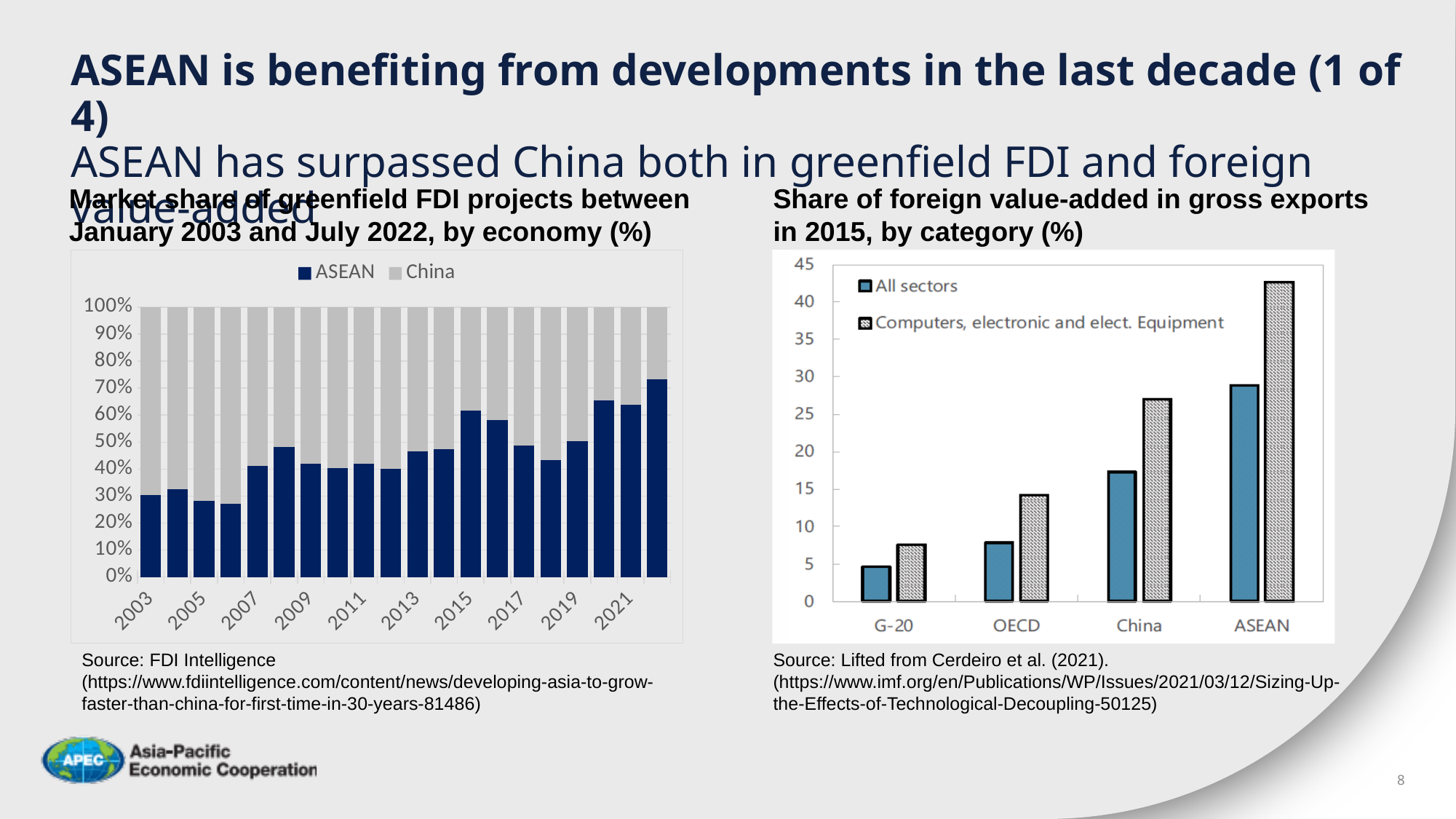
In the right chart (share of foreign value-added in gross exports), is the ASEAN value for Computers, electronic and elect. Equipment greater or less than 40? greater How many series does the legend of the left chart (greenfield FDI projects) list? 2 In the left chart (greenfield FDI projects), which year has the highest ASEAN share? 2022 How many categories are shown on the x axis of the right chart (share of foreign value-added in gross exports)? 4 In the right chart (share of foreign value-added in gross exports), which category has the highest value for Computers, electronic and elect. Equipment? ASEAN In the left chart (greenfield FDI projects), does the ASEAN share generally rise or fall from 2003 to 2022? rise In the left chart (greenfield FDI projects), which series is shown in dark blue? ASEAN How many series does the legend of the right chart (share of foreign value-added in gross exports) list? 2 What kind of chart is the 'Market share of greenfield FDI projects' chart on the left? stacked bar chart In the right chart (share of foreign value-added in gross exports), which category has the lowest value for All sectors? G-20 In the left chart (greenfield FDI projects), is the ASEAN share in 2022 greater or less than 70%? greater In the left chart (greenfield FDI projects), is the ASEAN share in 2006 greater or less than 30%? less